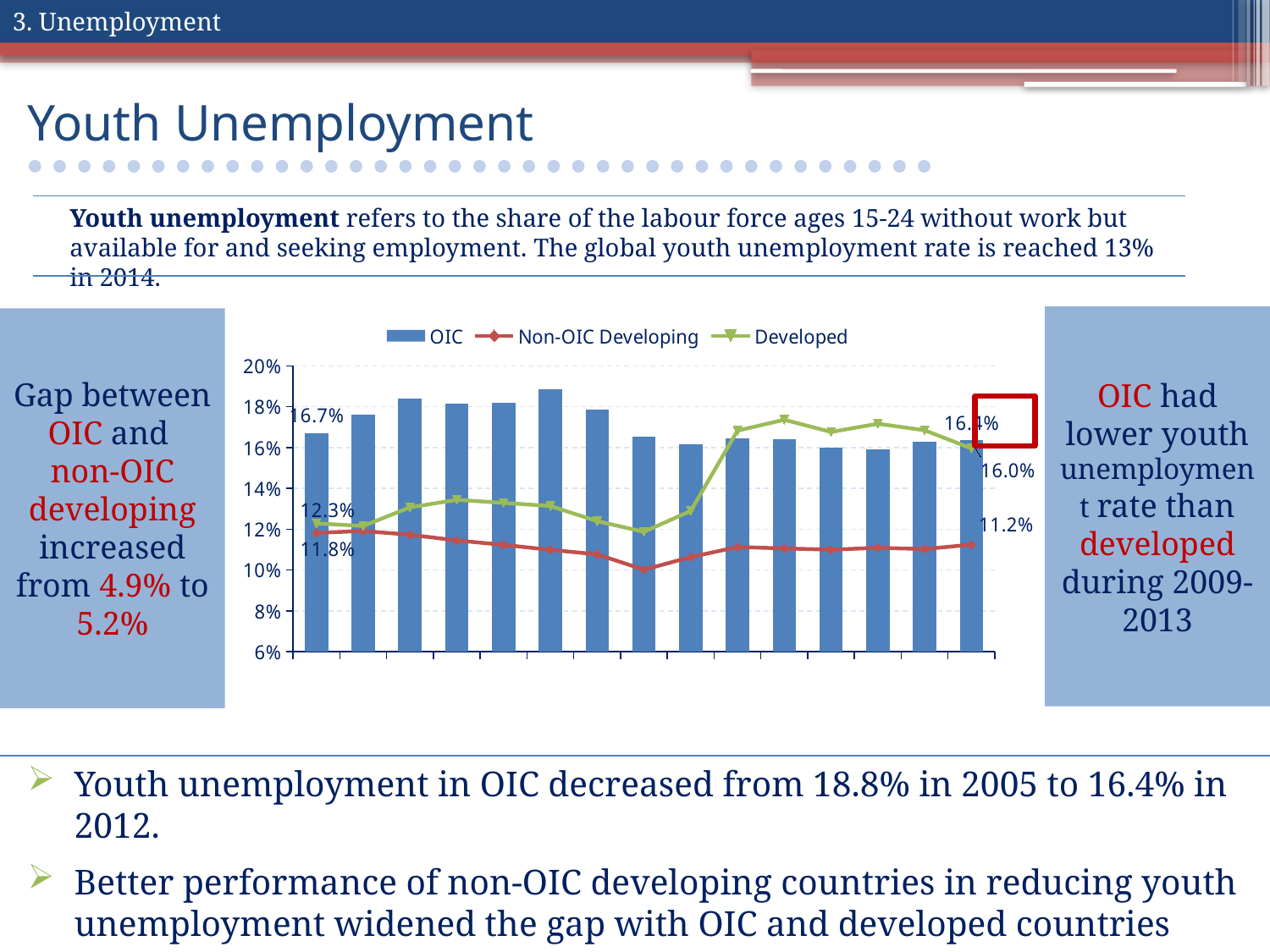
What is the labelled value of the first Developed point in the chart? 12.3% What is the labelled value of the last Non-OIC Developing point in the chart? 11.2% What are the three series named in the chart legend? OIC, Non-OIC Developing, Developed What is the labelled value of the last Developed point in the chart? 16.0% At the first point in the chart, which is larger: the OIC value or the Developed value? OIC What is the difference between the first OIC value (16.7%) and the first Non-OIC Developing value (11.8%)? 4.9% What is the labelled value of the first OIC bar in the chart? 16.7% Does the Developed line rise or fall overall from its first point to its last point? rises What is the labelled value of the first Non-OIC Developing point in the chart? 11.8% What kind of chart is shown on the slide? A combination bar and line chart How many series does the chart legend list? 3 Is the highest OIC bar in the chart greater or less than 18%? greater